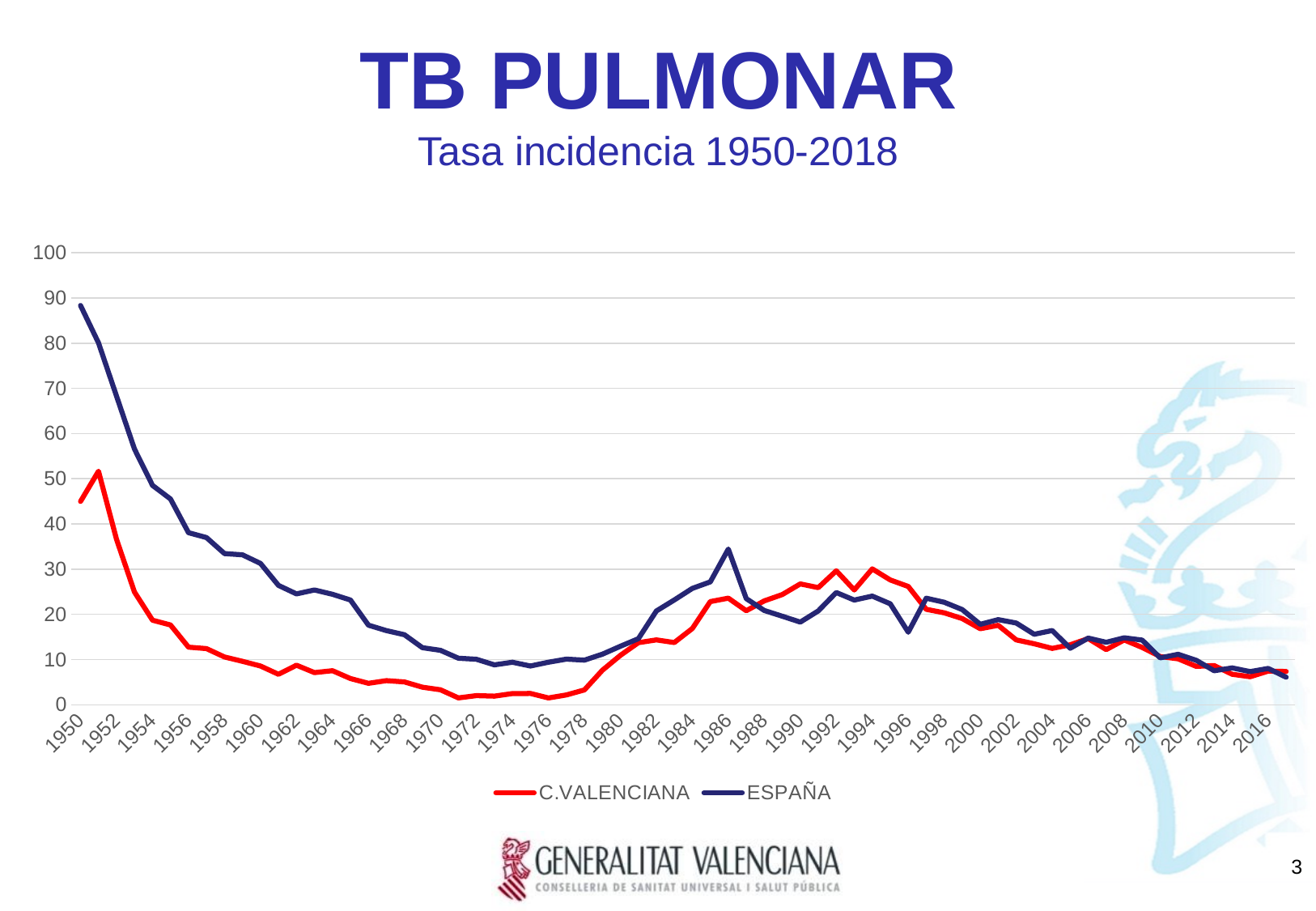
Which series reaches the highest value anywhere on the chart? ESPAÑA Is the value for ESPAÑA in 1950 greater or less than 80? greater Does the ESPAÑA line rise or fall between 1950 and 1976? Fall Is the value for ESPAÑA in 1986 greater or less than 30? greater What are the two series named in the legend? C.VALENCIANA and ESPAÑA What kind of chart is shown on the slide? Line chart How many series does the legend list? 2 What colour is the ESPAÑA line? Dark blue In 1950, which series has the higher value, C.VALENCIANA or ESPAÑA? ESPAÑA In 1992, which series has the higher value, C.VALENCIANA or ESPAÑA? C.VALENCIANA Is the value for C.VALENCIANA in 1972 greater or less than 10? less